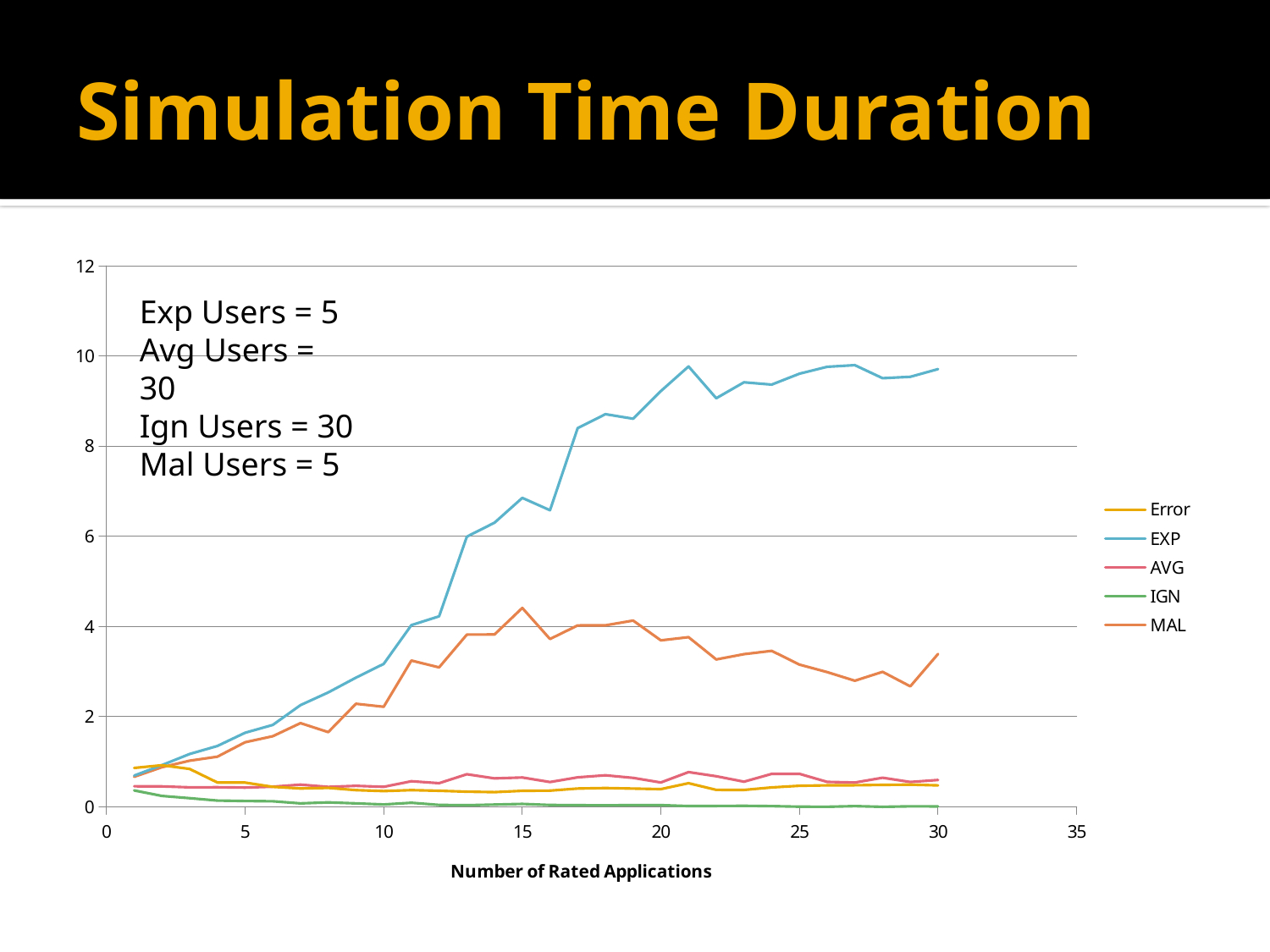
How many series does the legend list? 5 What is the label of the x axis? Number of Rated Applications Does the EXP series rise or fall as the number of rated applications increases? rises At 30 rated applications, which is larger, EXP or MAL? EXP Is the value of MAL at 30 rated applications greater or less than 4? less Is the value of EXP at 30 rated applications greater or less than 8? greater Is the value of MAL at 10 rated applications greater or less than 4? less What kind of chart is shown on the slide? line chart Which series has the lowest value at 30 rated applications? IGN Which series reaches the highest value on the chart? EXP What is the title of the slide's chart? Simulation Time Duration At 30 rated applications, which is larger, AVG or IGN? AVG